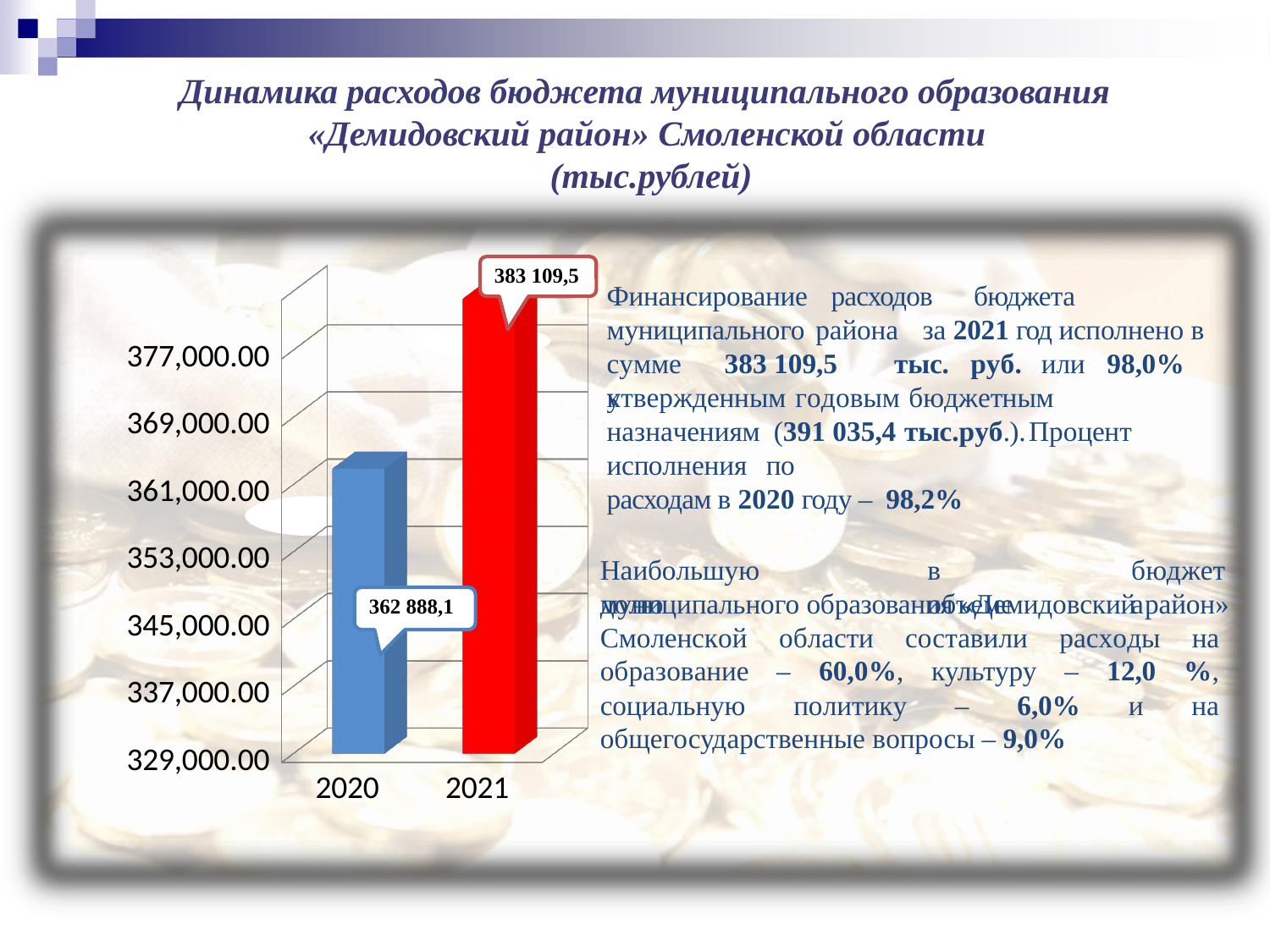
Which year has the lowest value in the chart? 2020 How many years (categories) are shown in the chart? 2 Is the value for 2021 greater or less than 377,000.00? greater What colour is the bar for 2021? red Which is larger, the value for 2020 or the value for 2021? 2021 What kind of chart is shown on the slide? bar chart Which year has the highest value in the chart? 2021 Do the values rise or fall from 2020 to 2021? rise What is the value for 2021 in the chart? 383 109,5 Is the value for 2020 greater or less than 353,000.00? greater What is the value for 2020 in the chart? 362 888,1 What is the difference between the values for 2021 and 2020? 20 221,4